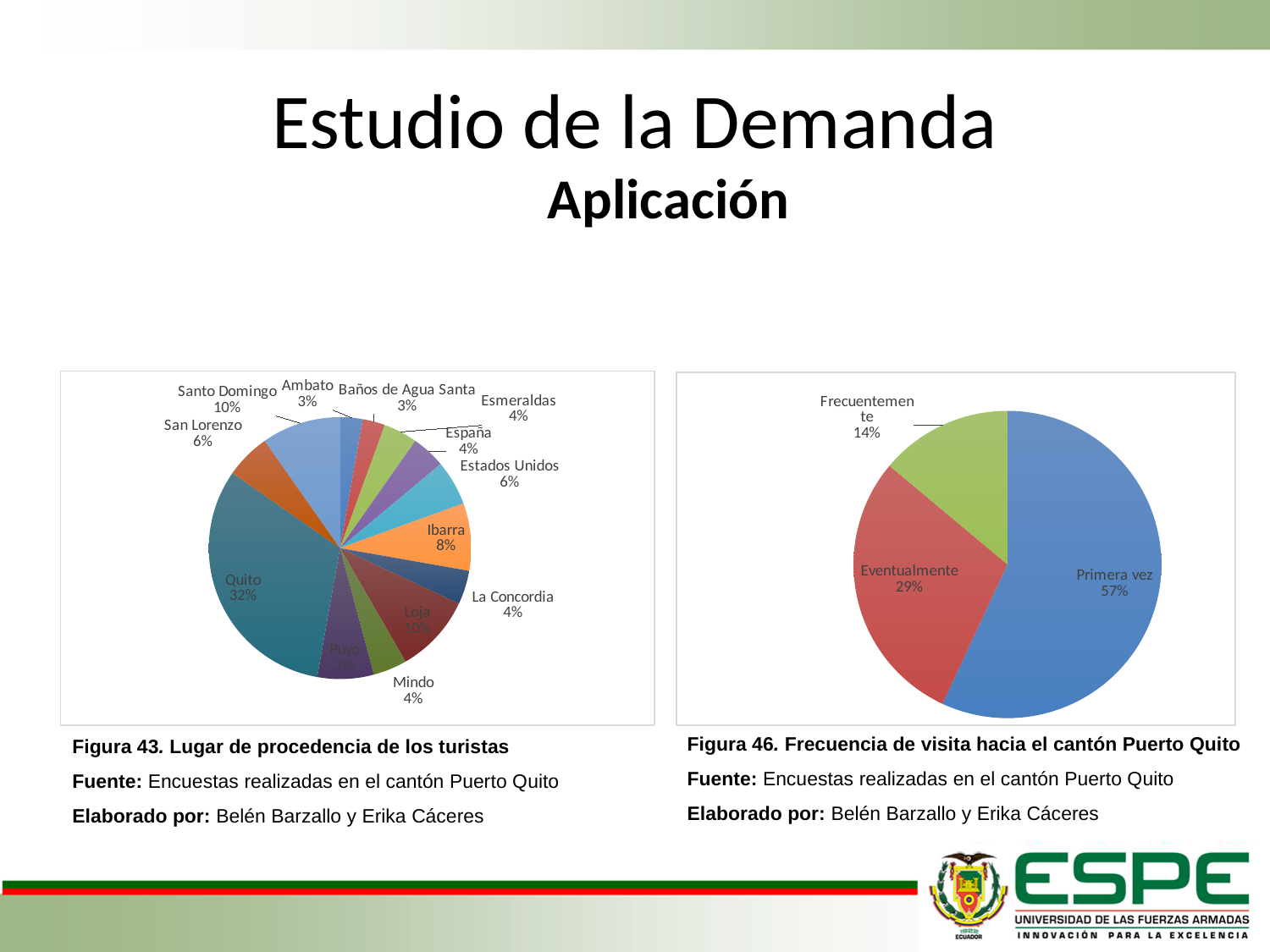
In the right chart (Figura 46), which visit frequency has the smallest slice? Frecuentemente In the left chart (Figura 43, Lugar de procedencia de los turistas), what share of tourists come from Quito? 32% In the right chart (Figura 46), how many categories are shown in the pie? 3 In the right chart (Figura 46, Frecuencia de visita hacia el cantón Puerto Quito), what share of visitors are visiting for the first time (Primera vez)? 57% In the left chart (Figura 43), what is the difference in percentage points between Quito and Santo Domingo? 22 In the right chart (Figura 46), what percentage corresponds to Frecuentemente? 14% In the left chart (Figura 43), how many places of origin are shown as slices? 13 What type of chart is used in Figura 43 on the left? Pie chart In the left chart (Figura 43), what percentage is shown for Ibarra? 8% In the left chart (Figura 43), which is larger, the share for Estados Unidos or the share for Esmeraldas? Estados Unidos In the right chart (Figura 46), what is the difference in percentage points between Primera vez and Eventualmente? 28 In the left chart (Figura 43), which place of origin has the largest slice? Quito